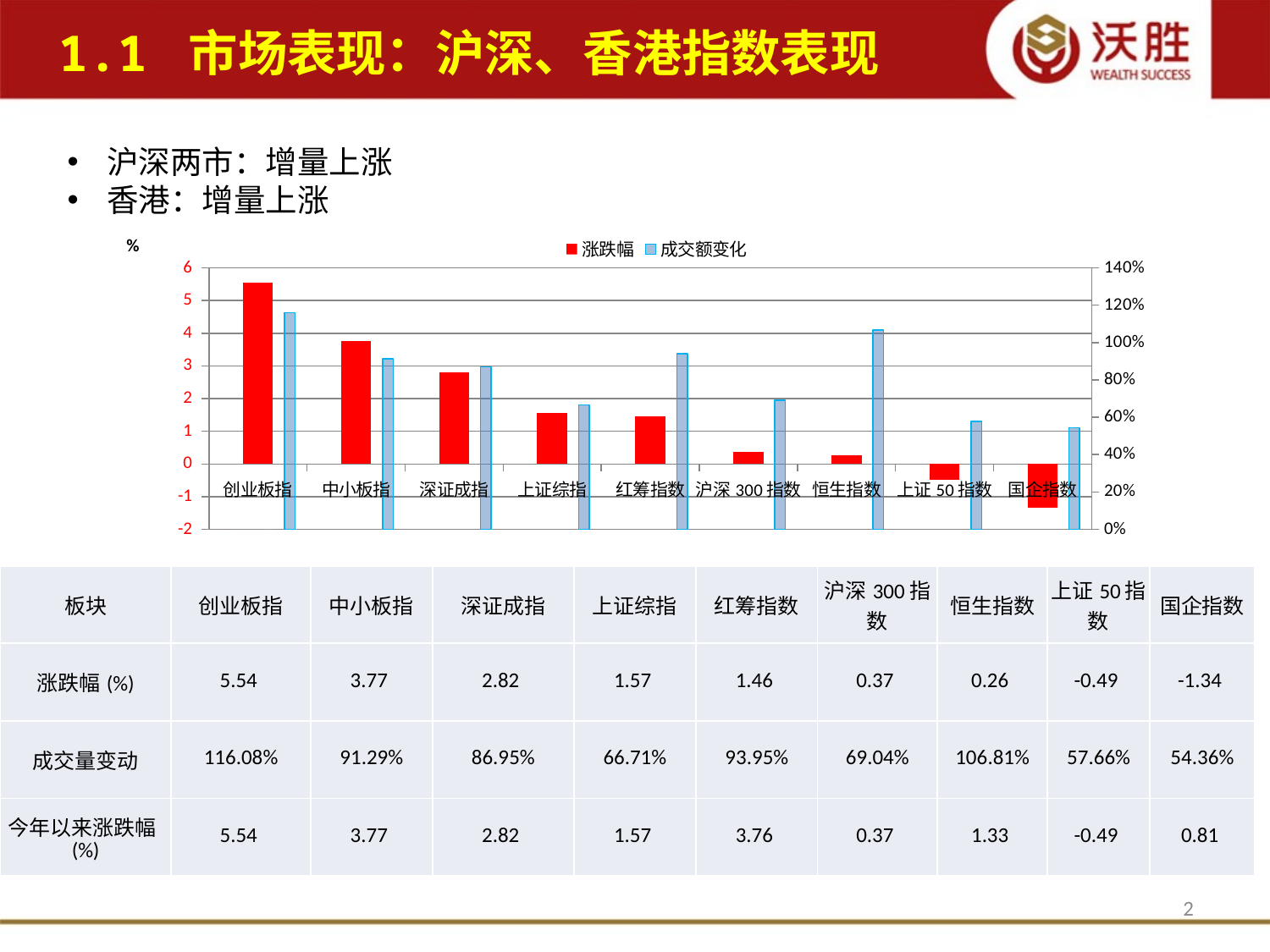
What kind of chart is shown on the slide? bar chart Which index has the highest 成交额变化 in the chart? 创业板指 Which index has the lowest 成交额变化 in the chart? 国企指数 How many index categories are plotted along the x axis of the chart? 9 Which index has the lowest 涨跌幅 in the chart? 国企指数 Which index has the highest 涨跌幅 in the chart? 创业板指 Is the 涨跌幅 value for 创业板指 greater or less than 5? greater Is the 成交额变化 value for 恒生指数 greater or less than 100%? greater Do the red 涨跌幅 bars rise or fall from left to right along the x axis? fall Which has a larger 成交额变化, 红筹指数 or 沪深300指数? 红筹指数 How many series does the chart legend list? 2 What colour are the 涨跌幅 bars in the chart? red